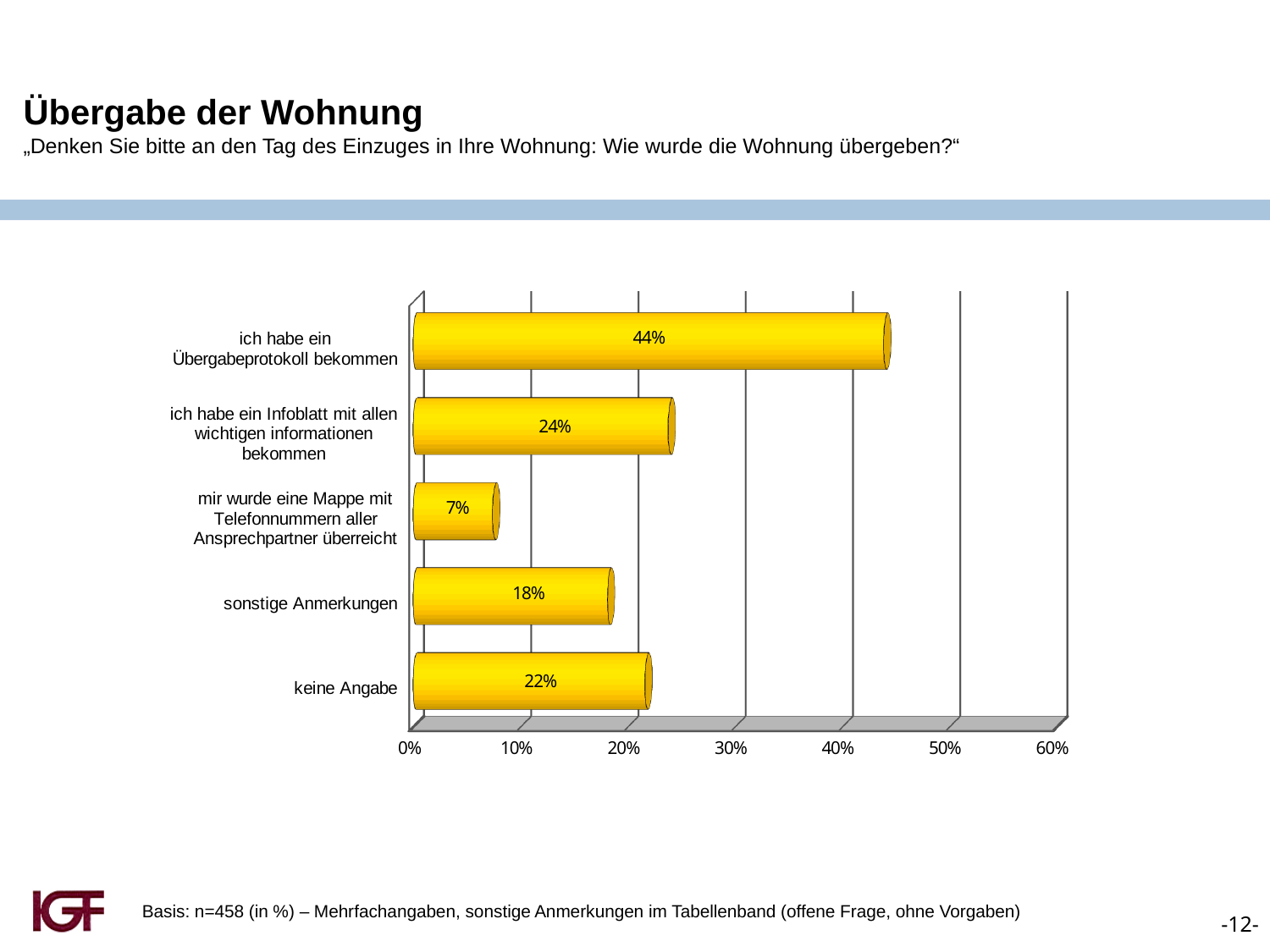
What kind of chart is shown on the slide? bar chart What is the value for "mir wurde eine Mappe mit Telefonnummern aller Ansprechpartner überreicht"? 7% Which category has the highest value? ich habe ein Übergabeprotokoll bekommen What is the value for "keine Angabe"? 22% What is the difference between "ich habe ein Übergabeprotokoll bekommen" and "ich habe ein Infoblatt mit allen wichtigen informationen bekommen"? 20% Which category has the lowest value? mir wurde eine Mappe mit Telefonnummern aller Ansprechpartner überreicht What is the maximum value shown on the x axis? 60% What is the value for "ich habe ein Infoblatt mit allen wichtigen informationen bekommen"? 24% Is the value for "sonstige Anmerkungen" greater or less than 20%? less What percentage of respondents said "ich habe ein Übergabeprotokoll bekommen"? 44% Which is larger: "sonstige Anmerkungen" or "keine Angabe"? keine Angabe How many categories are shown in the chart? 5